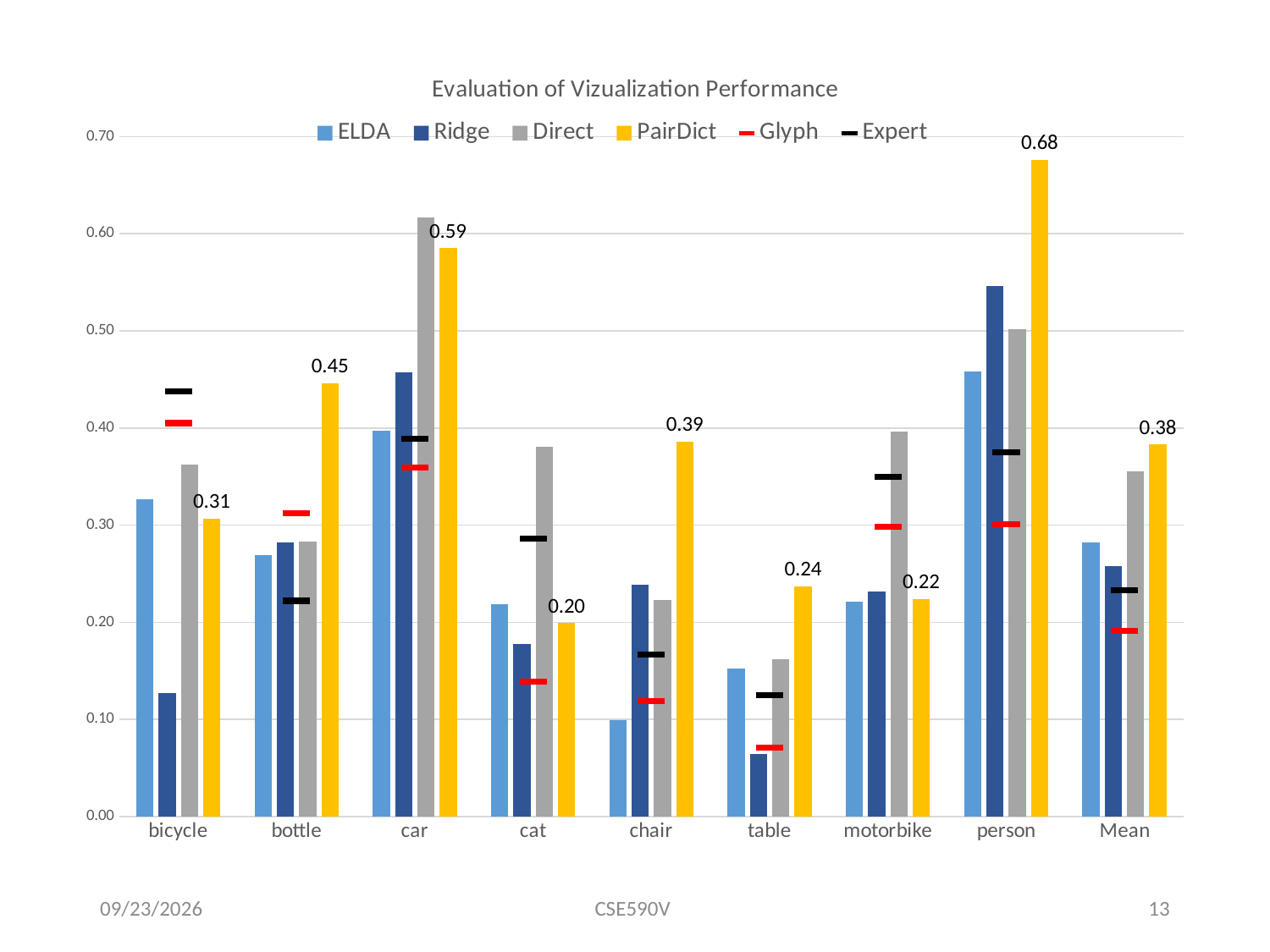
Is the Ridge value for table greater or less than 0.10? less How many series does the legend list? 6 How many categories are shown on the x axis? 9 Which category has the highest PairDict value? person What is the difference between the PairDict values for person and car? 0.09 What is the PairDict value for car? 0.59 What is the title of the chart? Evaluation of Vizualization Performance Which has a larger PairDict value, bottle or chair? bottle Which category has the lowest PairDict value? cat What is the PairDict value for person? 0.68 Is the ELDA value for bicycle greater or less than 0.30? greater What is the PairDict value for Mean? 0.38